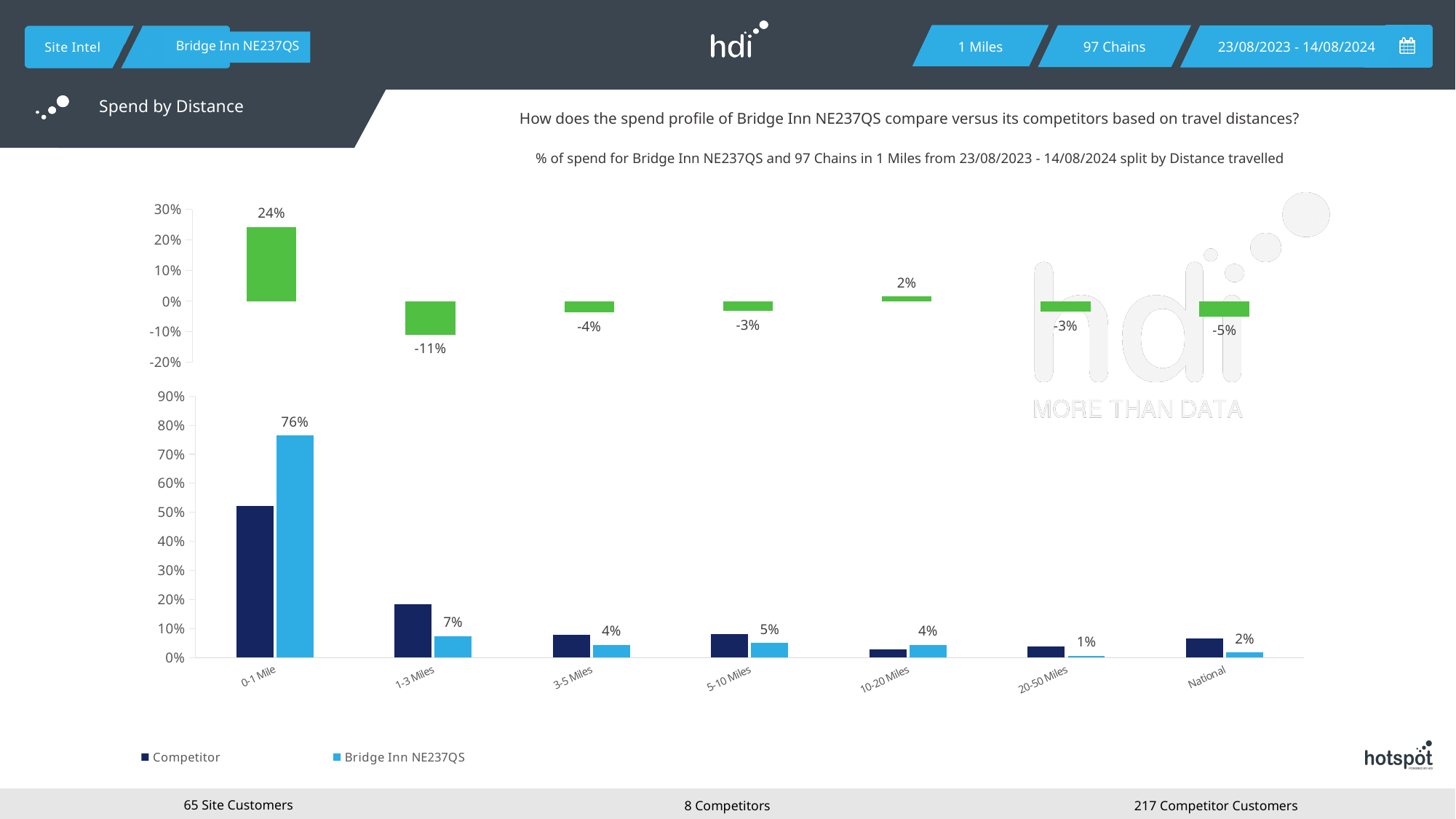
In the top chart, what is the value shown on the leftmost green bar? 24% In the bottom chart, is the Competitor value for 0-1 Mile greater or less than 40%? greater What type of chart is the bottom chart? bar chart In the bottom chart, what is the value for Bridge Inn NE237QS in the 1-3 Miles category? 7% In the bottom chart, which distance category has the lowest value for Bridge Inn NE237QS? 20-50 Miles How many distance categories are shown on the x axis of the bottom chart? 7 How many series does the legend of the bottom chart list? 2 In the bottom chart, what is the value for Bridge Inn NE237QS in the 20-50 Miles category? 1% In the bottom chart, what is the value for Bridge Inn NE237QS in the 0-1 Mile category? 76% In the bottom chart, in the 0-1 Mile category, which series has the larger value, Competitor or Bridge Inn NE237QS? Bridge Inn NE237QS In the bottom chart, which distance category has the highest value for Bridge Inn NE237QS? 0-1 Mile In the bottom chart, what is the difference between the Bridge Inn NE237QS values for 0-1 Mile and 1-3 Miles? 69%